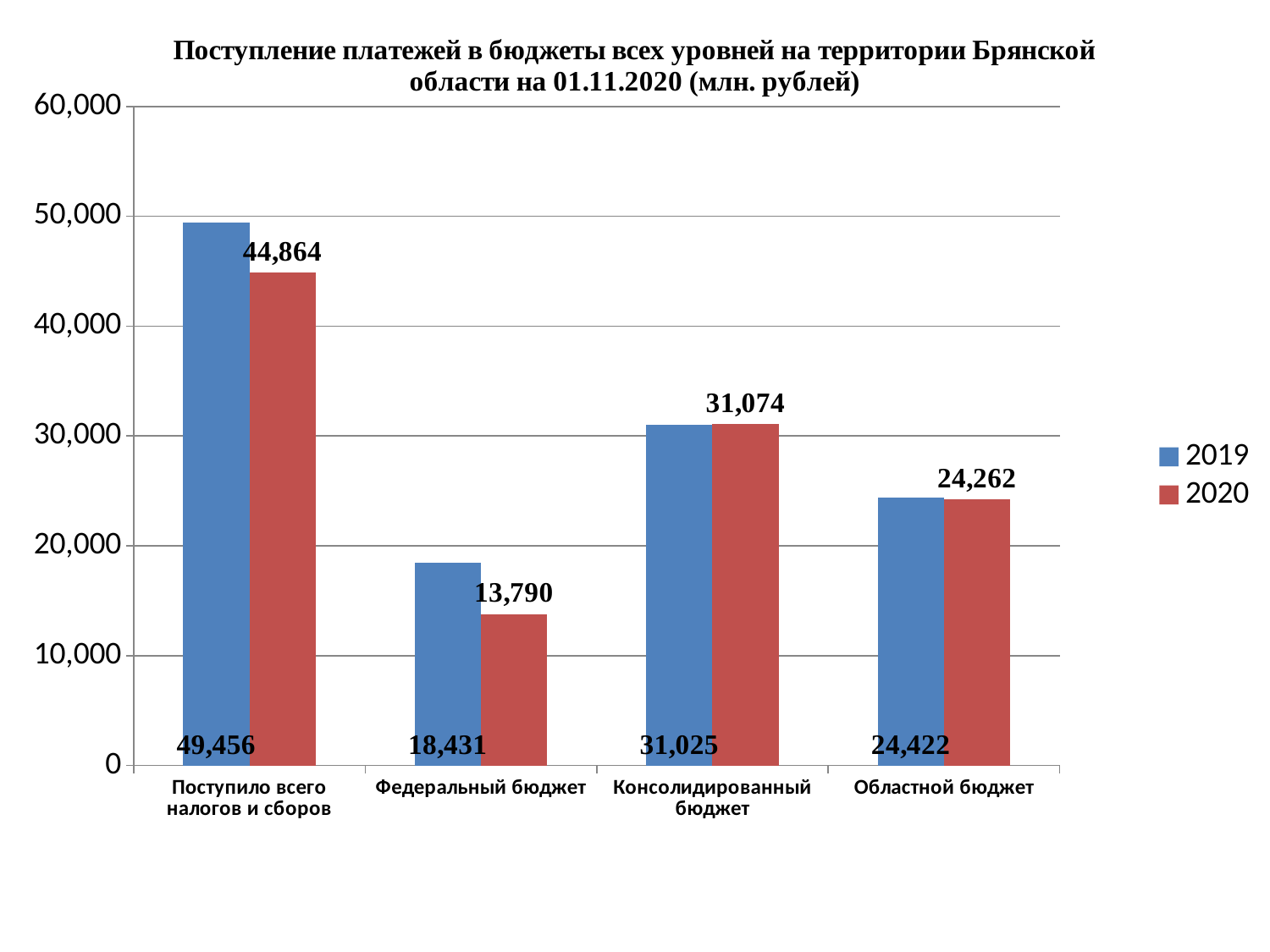
What is the 2019 value for Консолидированный бюджет? 31,025 Is the 2019 value for Областной бюджет greater or less than 20,000? greater What is the 2020 value for Областной бюджет? 24,262 Which category has the highest 2020 value? Поступило всего налогов и сборов How many categories are shown on the x axis? 4 Which category has the lowest 2019 value? Федеральный бюджет What is the difference between the 2019 and 2020 values for Поступило всего налогов и сборов? 4,592 What is the 2019 value for Поступило всего налогов и сборов? 49,456 For Федеральный бюджет, which is larger: the 2019 value or the 2020 value? 2019 What is the difference between the 2019 and 2020 values for Федеральный бюджет? 4,641 What is the 2020 value for Федеральный бюджет? 13,790 How many series does the legend list? 2